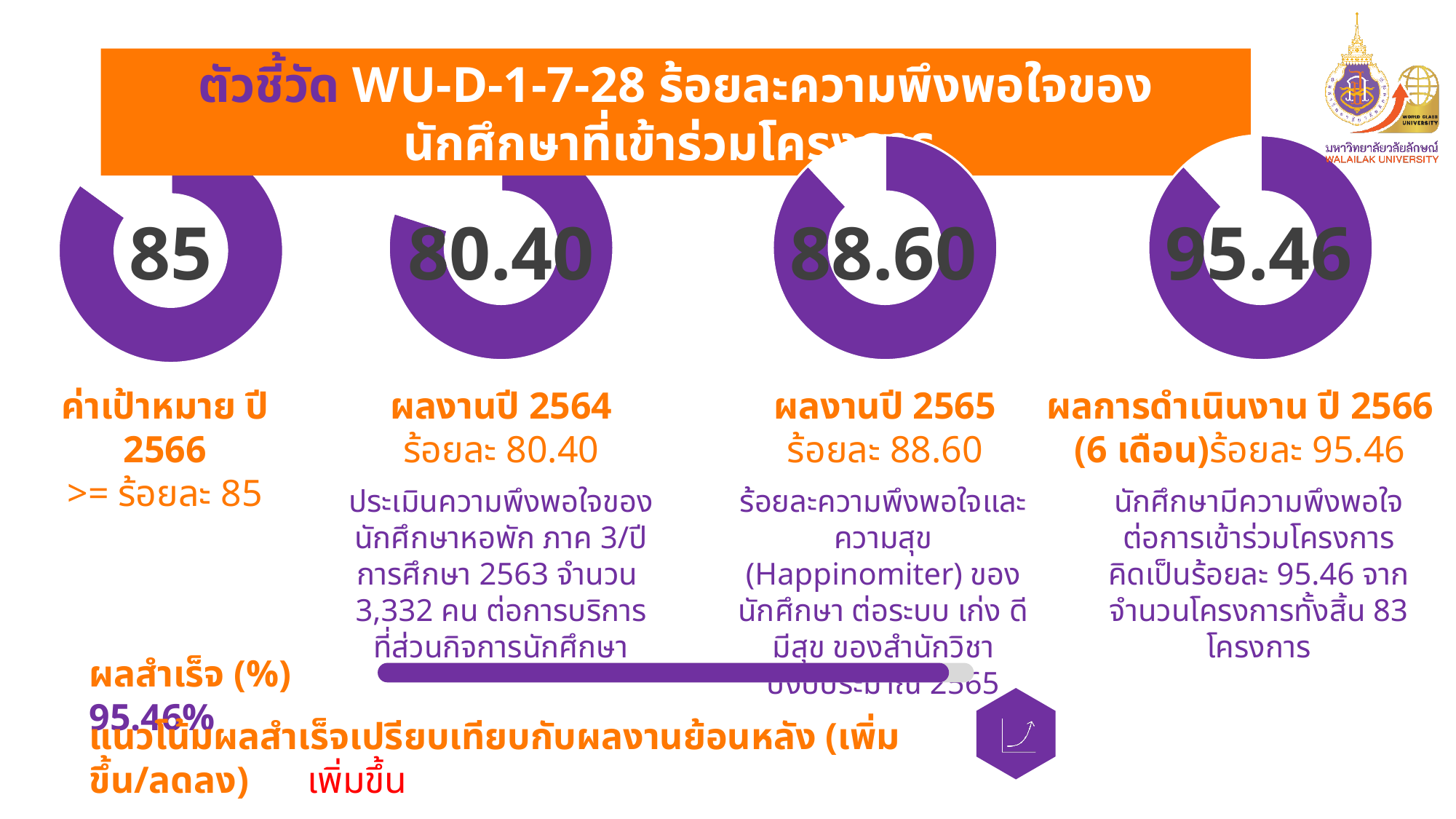
Which of the four donut charts shows the highest value? ผลการดำเนินงาน ปี 2566 (6 เดือน) What value is shown in the rightmost donut chart (ผลการดำเนินงาน ปี 2566 (6 เดือน))? 95.46 What value is shown in the centre of the first donut chart (ค่าเป้าหมาย ปี 2566)? 85 How many donut charts are shown on the slide? 4 Do the values rise or fall from ผลงานปี 2564 to ผลงานปี 2565 to ผลการดำเนินงาน ปี 2566? Rise What is the difference between the value for ผลงานปี 2565 and the value for ผลงานปี 2564? 8.20 Which is larger: the value for ผลงานปี 2564 or the value for ผลงานปี 2565? ผลงานปี 2565 Which of the four donut charts shows the lowest value? ผลงานปี 2564 What is the difference between the 2566 (6 เดือน) result and the 2566 target value? 10.46 What value is shown in the donut chart labelled ผลงานปี 2565? 88.60 What type of chart is used to display the values on this slide? Donut chart What value is shown in the donut chart labelled ผลงานปี 2564? 80.40